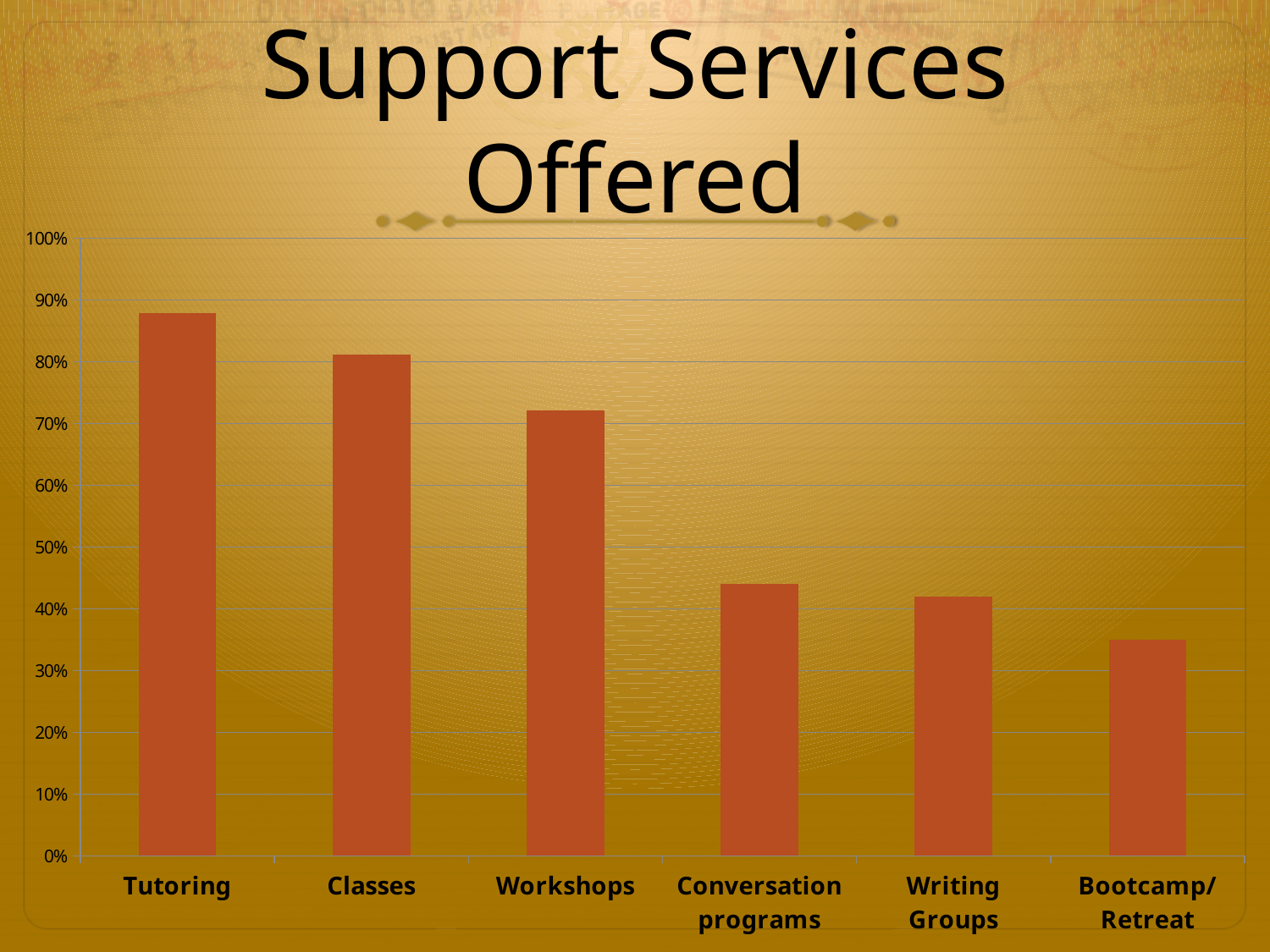
Is the value for Workshops greater or less than 70%? greater Is the value for Bootcamp/Retreat greater or less than 40%? less Is the value for Tutoring greater or less than 80%? greater Which is larger, the value for Writing Groups or the value for Bootcamp/Retreat? Writing Groups Which support service has the lowest value? Bootcamp/Retreat What type of chart is shown on the slide? bar chart What is the title of the chart? Support Services Offered Which is larger, the value for Classes or the value for Workshops? Classes Which support service has the highest value? Tutoring How many support service categories are shown on the chart? 6 Do the values rise or fall moving from left to right across the categories? fall